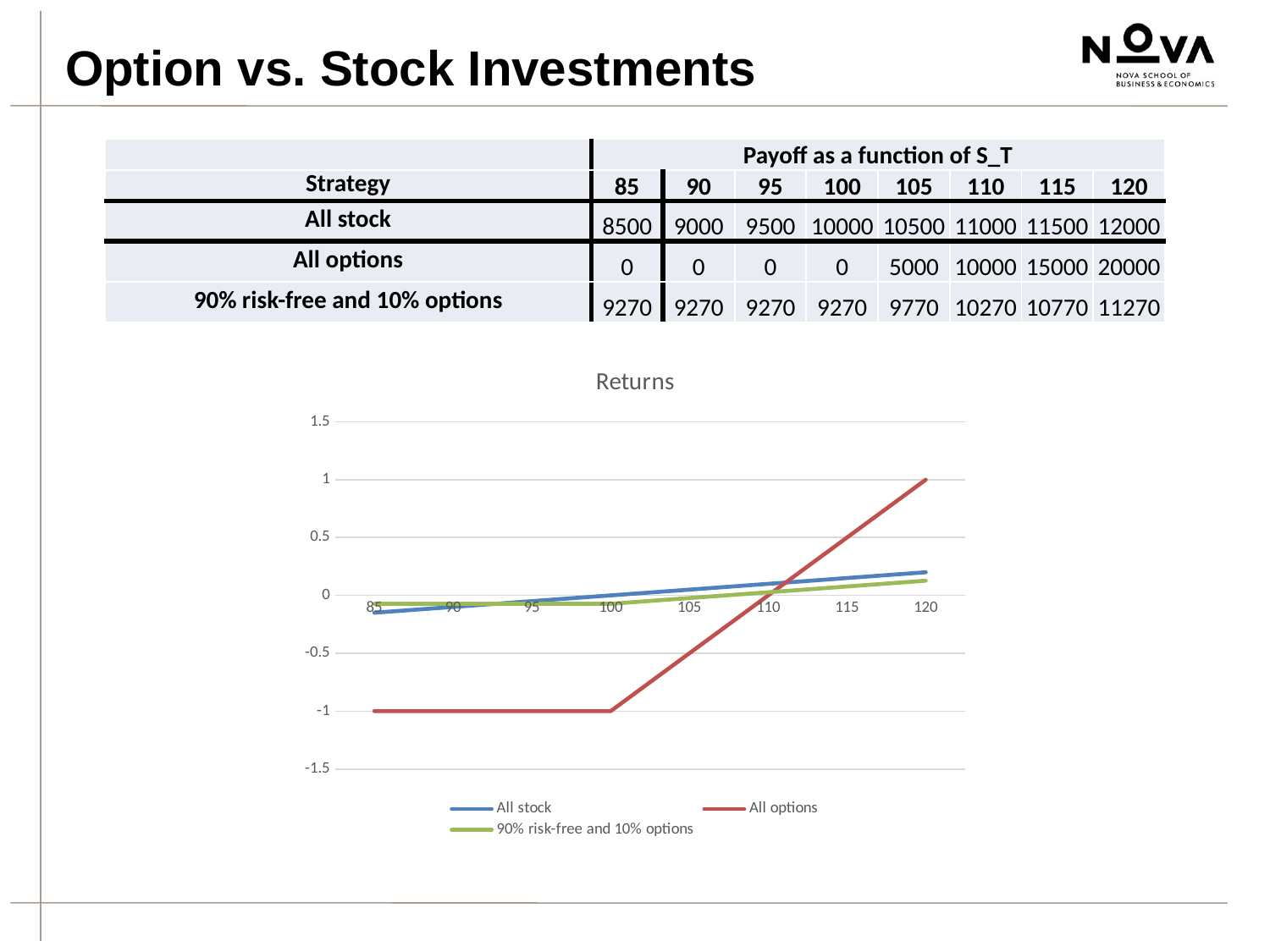
Which series has the lowest return at a stock price of 85? All options Is the return for All options at a stock price of 95 greater or less than -0.5? less Is the return for All stock at a stock price of 120 greater or less than 0.5? less How many series does the chart legend list? 3 What colour is the All options line in the chart? Red What is the return for the All options series at a stock price of 85? -1 What is the return for the All options series at a stock price of 120? 1 At a stock price of 120, which series has the higher return: All stock or All options? All options What kind of chart is shown on the slide? Line chart Does the All options line rise or fall between stock prices 100 and 120? Rises How many x-axis points (stock price values) are plotted in the chart? 8 What is the title of the chart? Returns